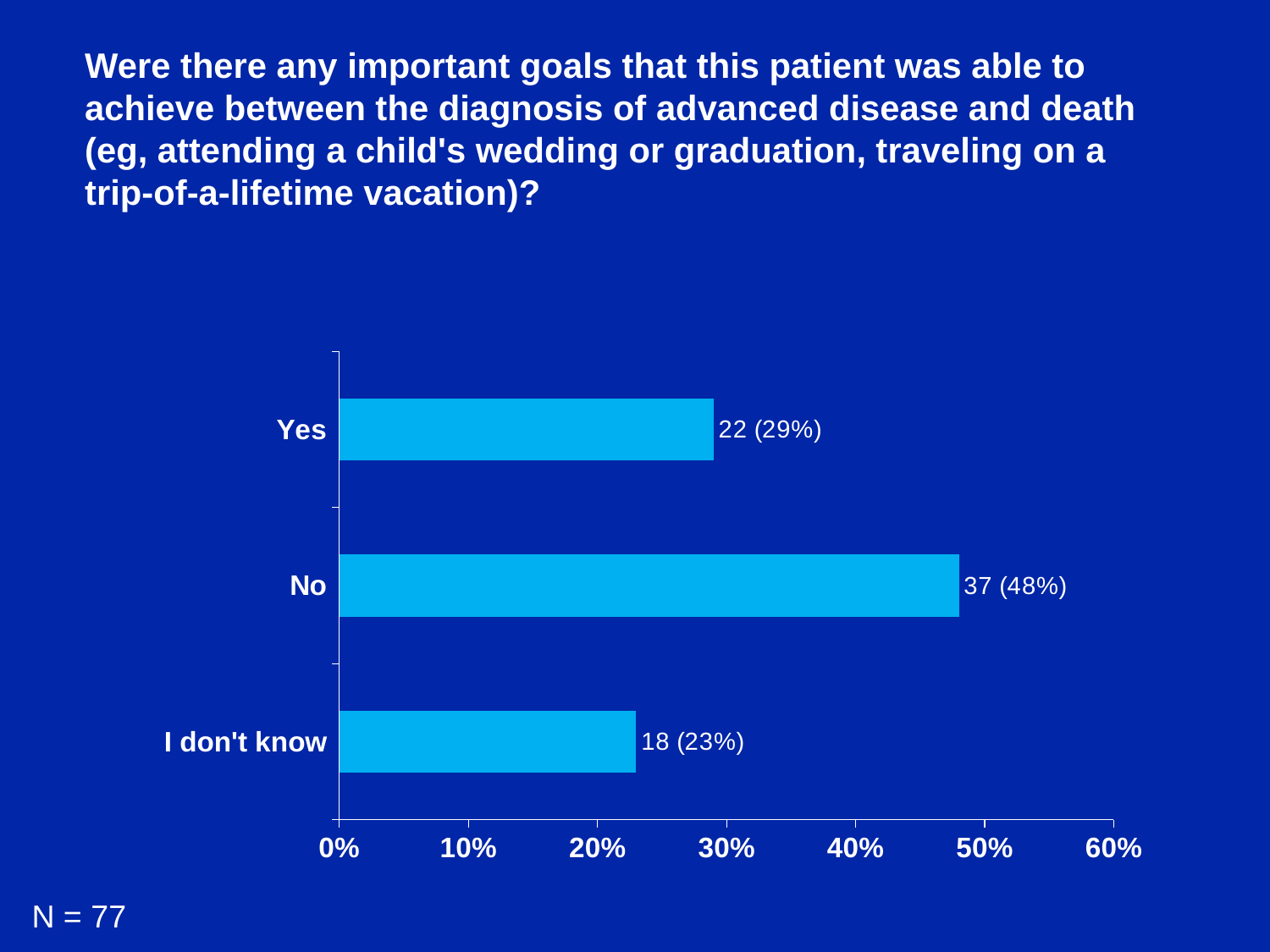
What is the data label shown for the "Yes" bar? 22 (29%) Which category has the lowest value? I don't know What is the sample size (N) stated on the slide? N = 77 What is the data label shown for the "I don't know" bar? 18 (23%) How many categories are shown in the chart? 3 Which is larger, the value for "Yes" or the value for "I don't know"? Yes Is the value for "No" greater or less than 40%? greater Which category has the highest value? No How many more respondents answered "Yes" than "I don't know"? 4 What kind of chart is shown on the slide? Bar chart What is the difference in percentage points between the "No" and "Yes" bars? 19% What is the data label shown for the "No" bar? 37 (48%)